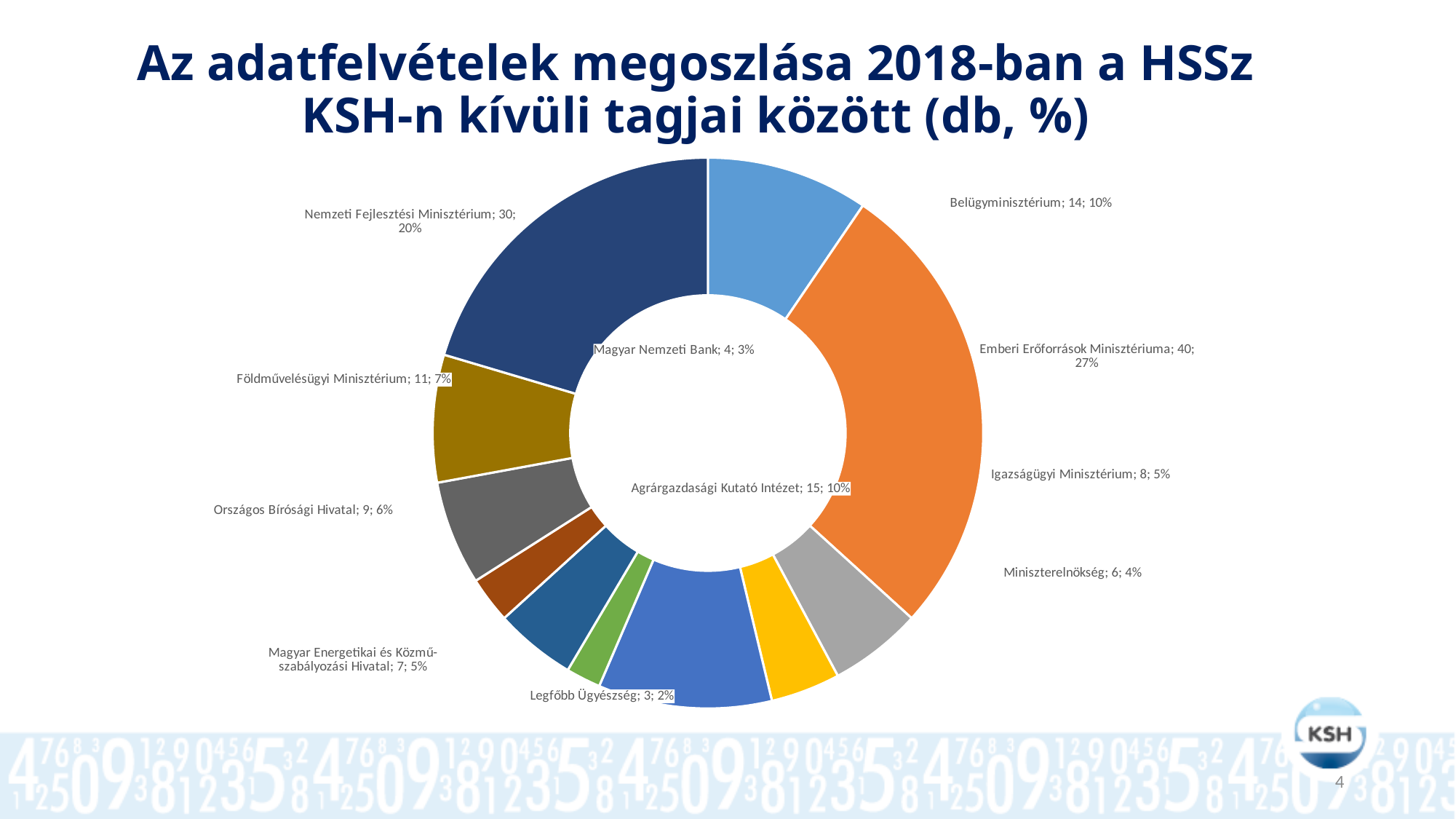
What share of the chart does Emberi Erőforrások Minisztériuma represent? 27% Which has a larger value, Országos Bírósági Hivatal or Igazságügyi Minisztérium? Országos Bírósági Hivatal What is the difference between the values for Emberi Erőforrások Minisztériuma and Nemzeti Fejlesztési Minisztérium? 10 How many data collections are shown for Belügyminisztérium? 14 Which category has the highest number of data collections? Emberi Erőforrások Minisztériuma What kind of chart is shown on the slide? Doughnut (pie) chart How many data collections are shown for Nemzeti Fejlesztési Minisztérium? 30 Which category has the lowest number of data collections? Legfőbb Ügyészség What is the title of the chart on the slide? Az adatfelvételek megoszlása 2018-ban a HSSz KSH-n kívüli tagjai között (db, %) How many data collections are shown for Agrárgazdasági Kutató Intézet? 15 What percentage is shown for Földművelésügyi Minisztérium? 7% How many categories are shown in the chart? 11